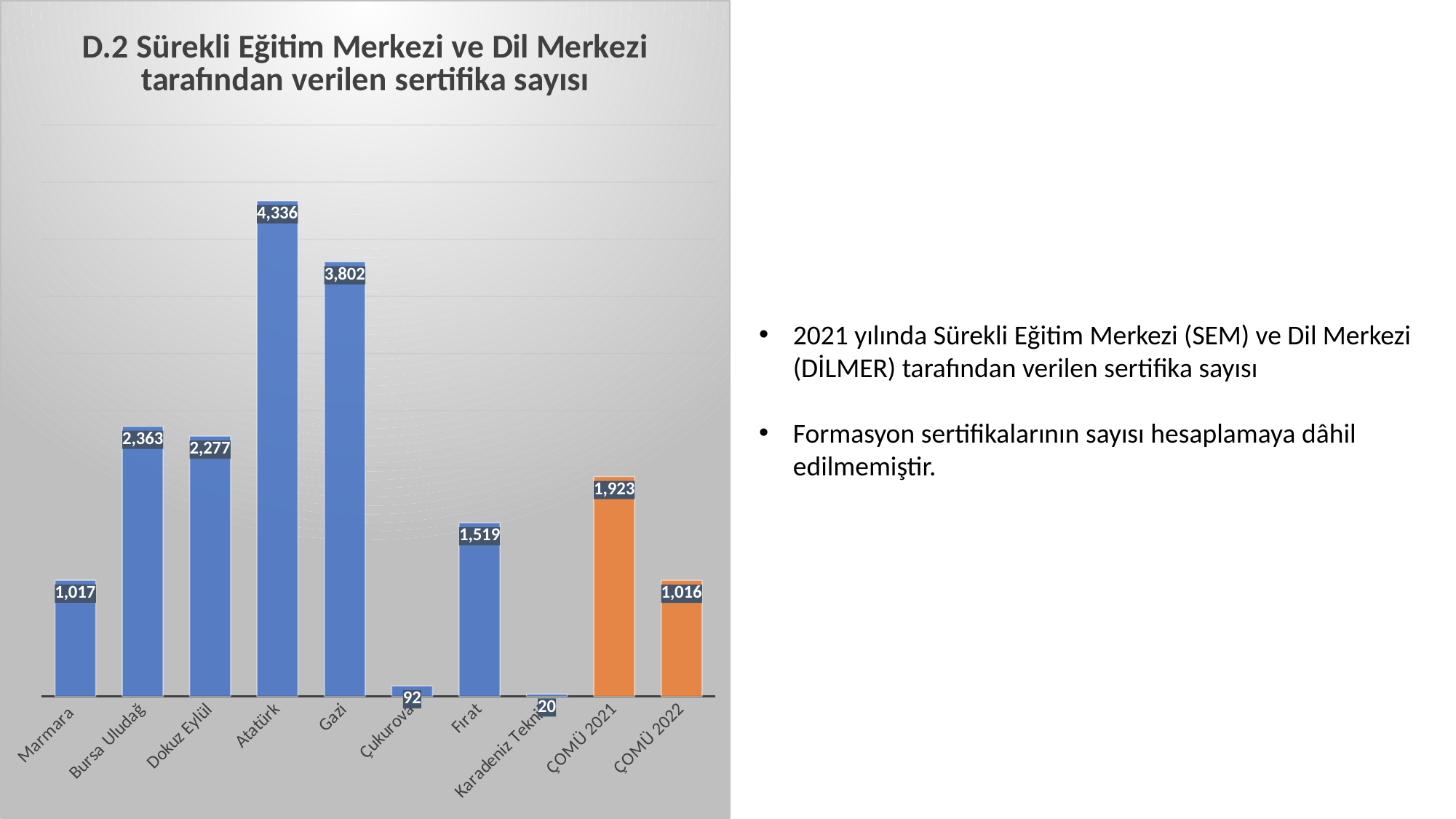
How many categories are shown on the x axis? 10 What is the difference between the values for Atatürk and Gazi? 534 What is the value for Çukurova? 92 Which bars are coloured orange rather than blue? ÇOMÜ 2021 and ÇOMÜ 2022 What is the value for ÇOMÜ 2021? 1,923 Which category has the highest value? Atatürk Which is larger, the value for Bursa Uludağ or the value for Dokuz Eylül? Bursa Uludağ What is the value for Atatürk? 4,336 What is the value for Fırat? 1,519 What is the difference between the values for ÇOMÜ 2021 and ÇOMÜ 2022? 907 What kind of chart is shown on the slide? Bar chart Which category has the lowest value? Karadeniz Teknik